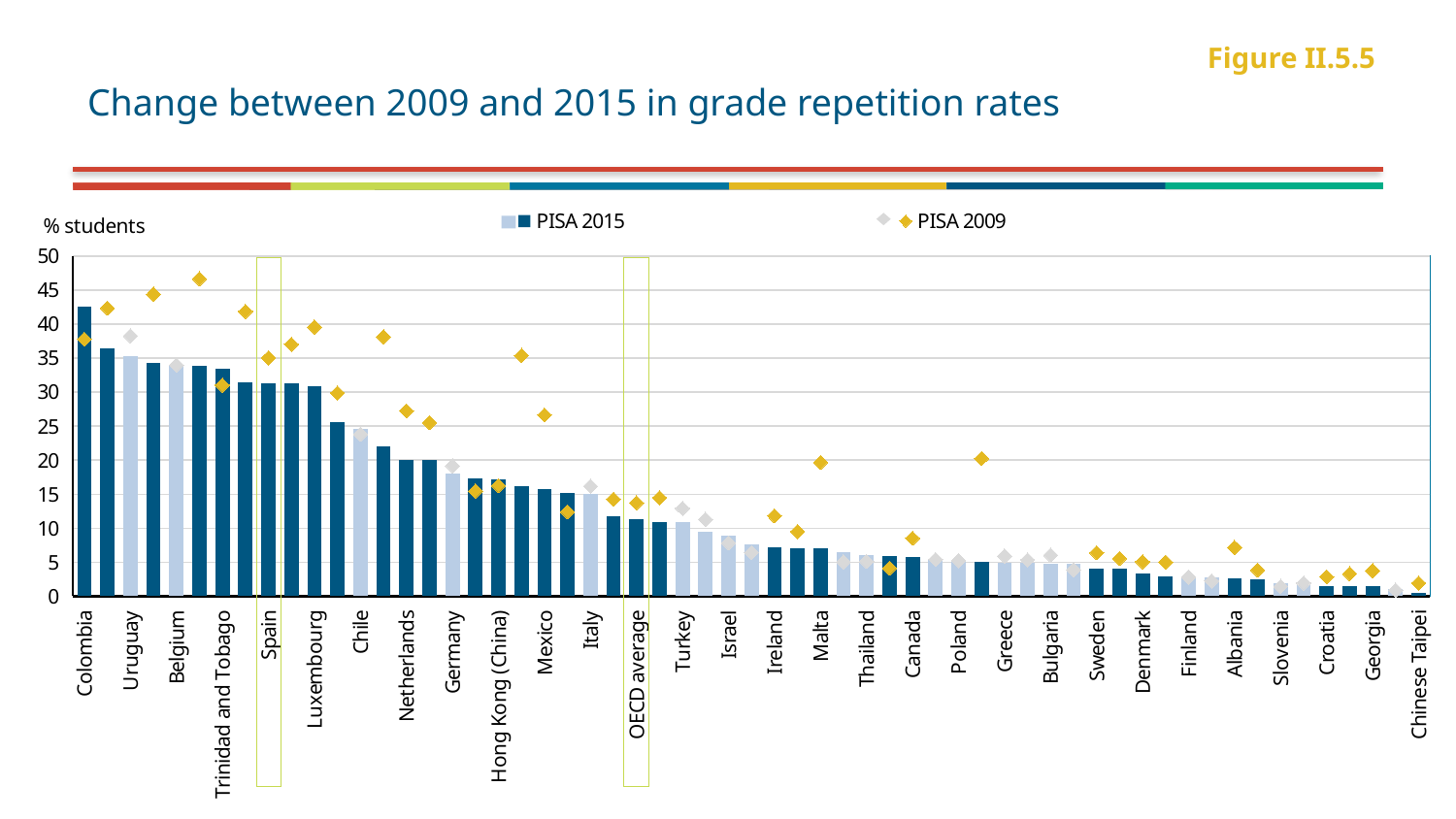
Do the PISA 2015 bars rise or fall moving from left to right across the chart? fall Is the PISA 2015 value for the OECD average greater or less than 15? less What is the label on the vertical axis? % students Is the PISA 2015 value for Uruguay greater or less than 30? greater What are the two series named in the legend? PISA 2015 and PISA 2009 Is the PISA 2015 value for Colombia greater or less than 40? greater What kind of chart is shown on the slide? bar chart How many series does the legend list? 2 Which country has the highest PISA 2015 bar? Colombia Which is larger for Spain, the PISA 2009 value or the PISA 2015 value? PISA 2009